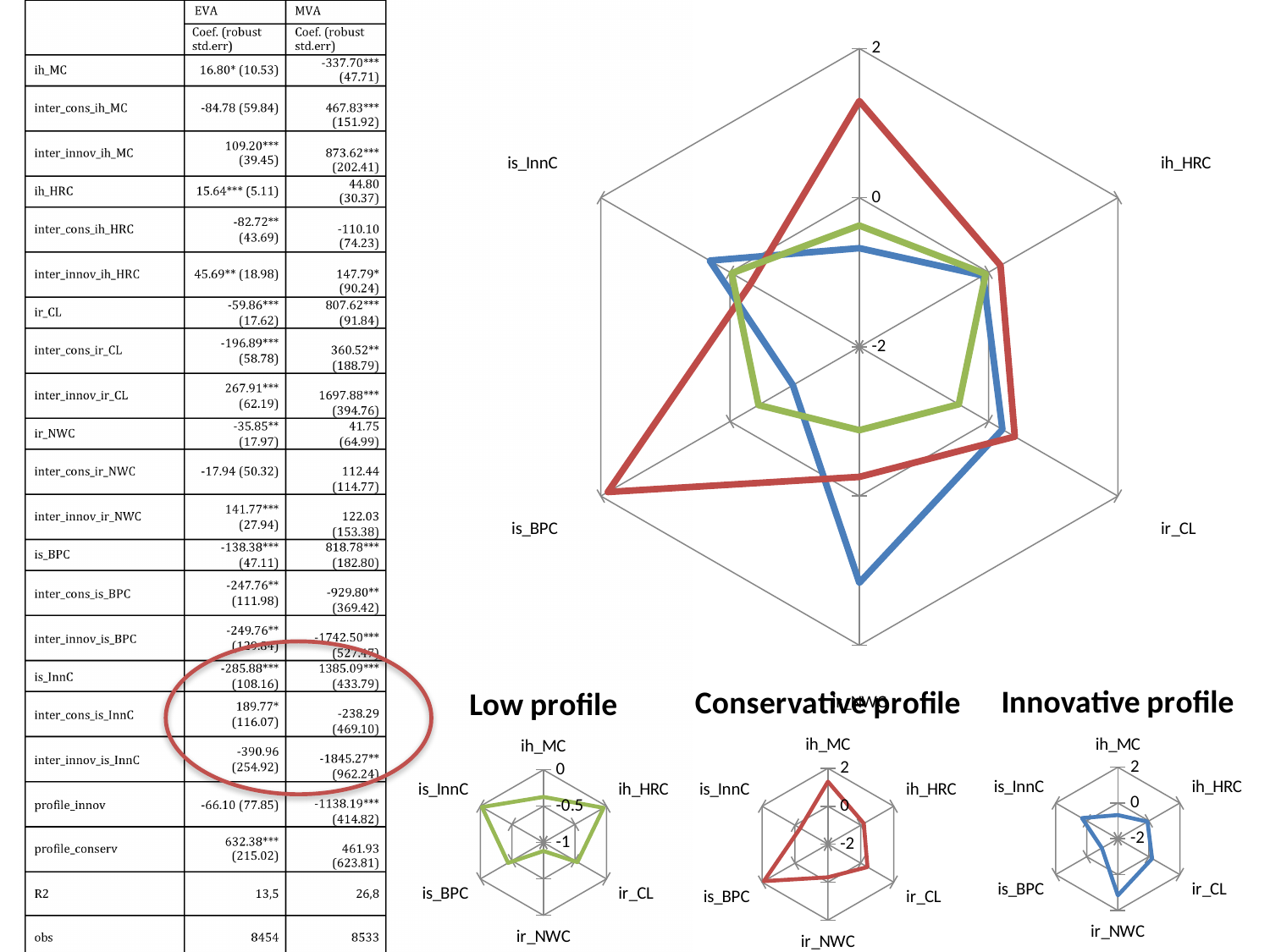
On the large radar chart, is the red series value for is_BPC greater or less than 0? greater On the large radar chart, is the green series value for ih_MC (top axis) greater or less than 0? less On the large radar chart, is the red series value for ih_MC (top axis) greater or less than 0? greater What kind of chart is the large chart in the upper right of the slide? Radar chart How many series are plotted on the large radar chart? 3 What are the titles of the three small radar charts at the bottom of the slide? Low profile, Conservative profile, Innovative profile On the large radar chart, which series reaches the highest value on the is_BPC axis? Red How many axes (categories) does the large radar chart have? 6 What colour is the series on the Low profile chart? Green